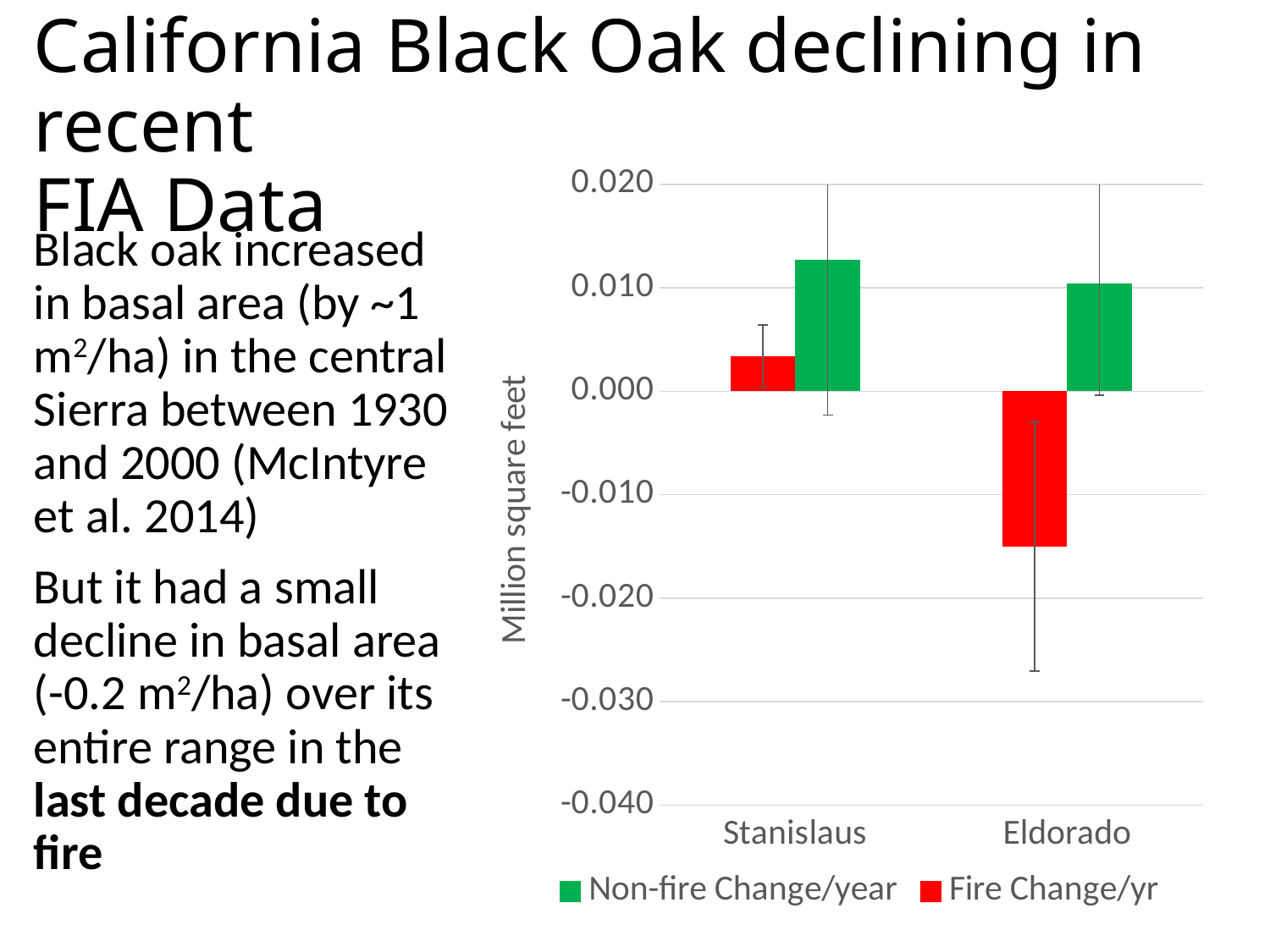
What kind of chart is shown on the slide? bar chart Which bar in the chart is the tallest (highest value)? Non-fire Change/year for Stanislaus Is the Fire Change/yr value for Stanislaus greater or less than 0.000? greater Which is larger, the Fire Change/yr value for Stanislaus or for Eldorado? Stanislaus Is the Non-fire Change/year value for Stanislaus greater or less than 0.010? greater Which colour represents the Fire Change/yr series in the chart? red What is the label on the vertical axis of the chart? Million square feet Is the Non-fire Change/year value for Eldorado greater or less than 0.000? greater How many series does the chart legend list? 2 How many categories are shown on the x axis of the chart? 2 Which category has the lowest Fire Change/yr value? Eldorado